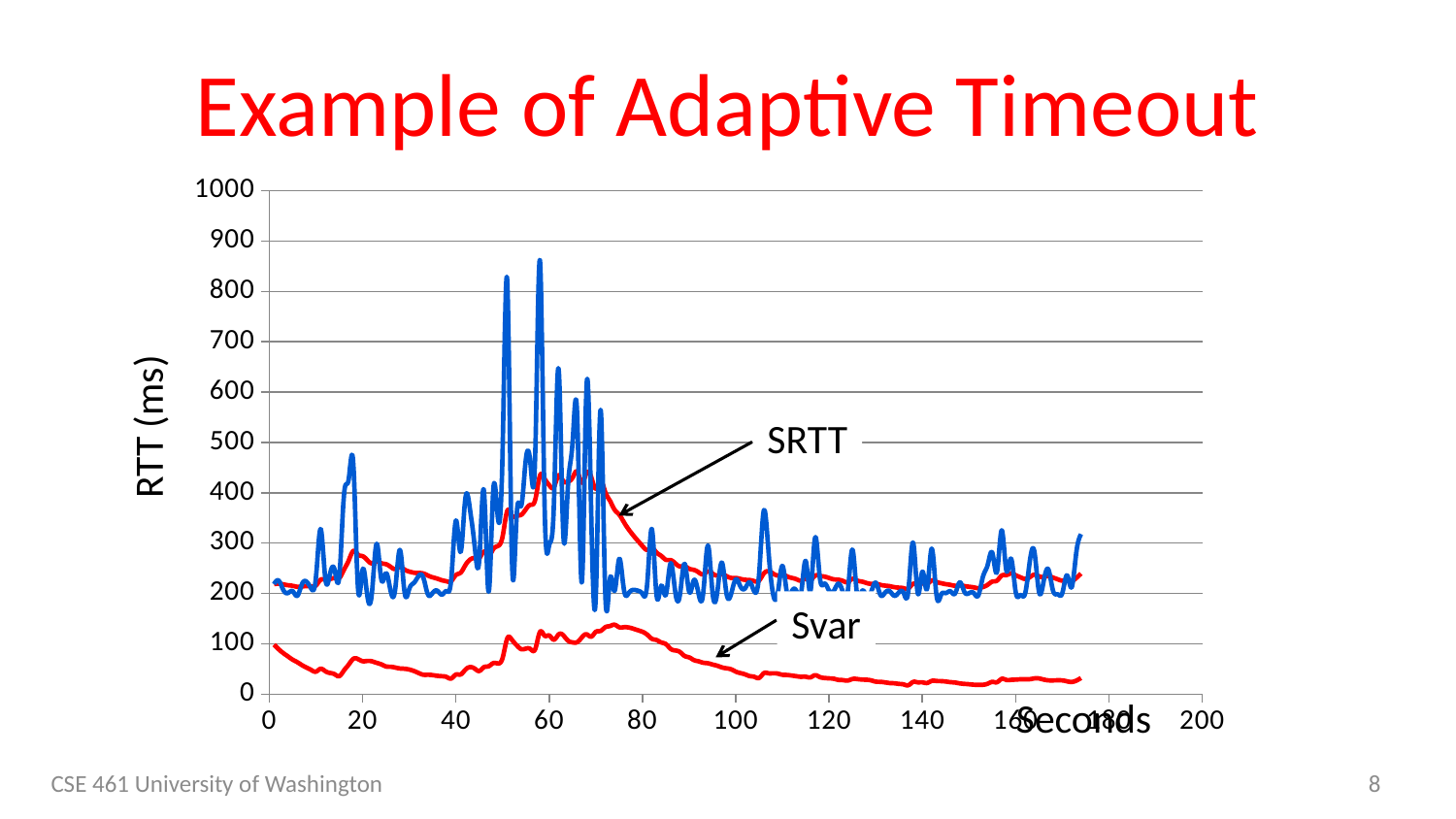
What kind of chart is shown on the slide? line chart What is the label on the vertical axis of the chart? RTT (ms) At 100 seconds, which is larger, SRTT or Svar? SRTT Is the highest peak of the blue line greater or less than 800? greater How many lines are plotted on the chart? 3 Is the value of SRTT at 60 seconds greater or less than 300? greater Does the SRTT line rise or fall between 70 and 140 seconds? fall What is the title of the chart on the slide? Example of Adaptive Timeout Is the value of Svar at 120 seconds greater or less than 100? less Does the Svar line rise or fall between 80 and 120 seconds? fall